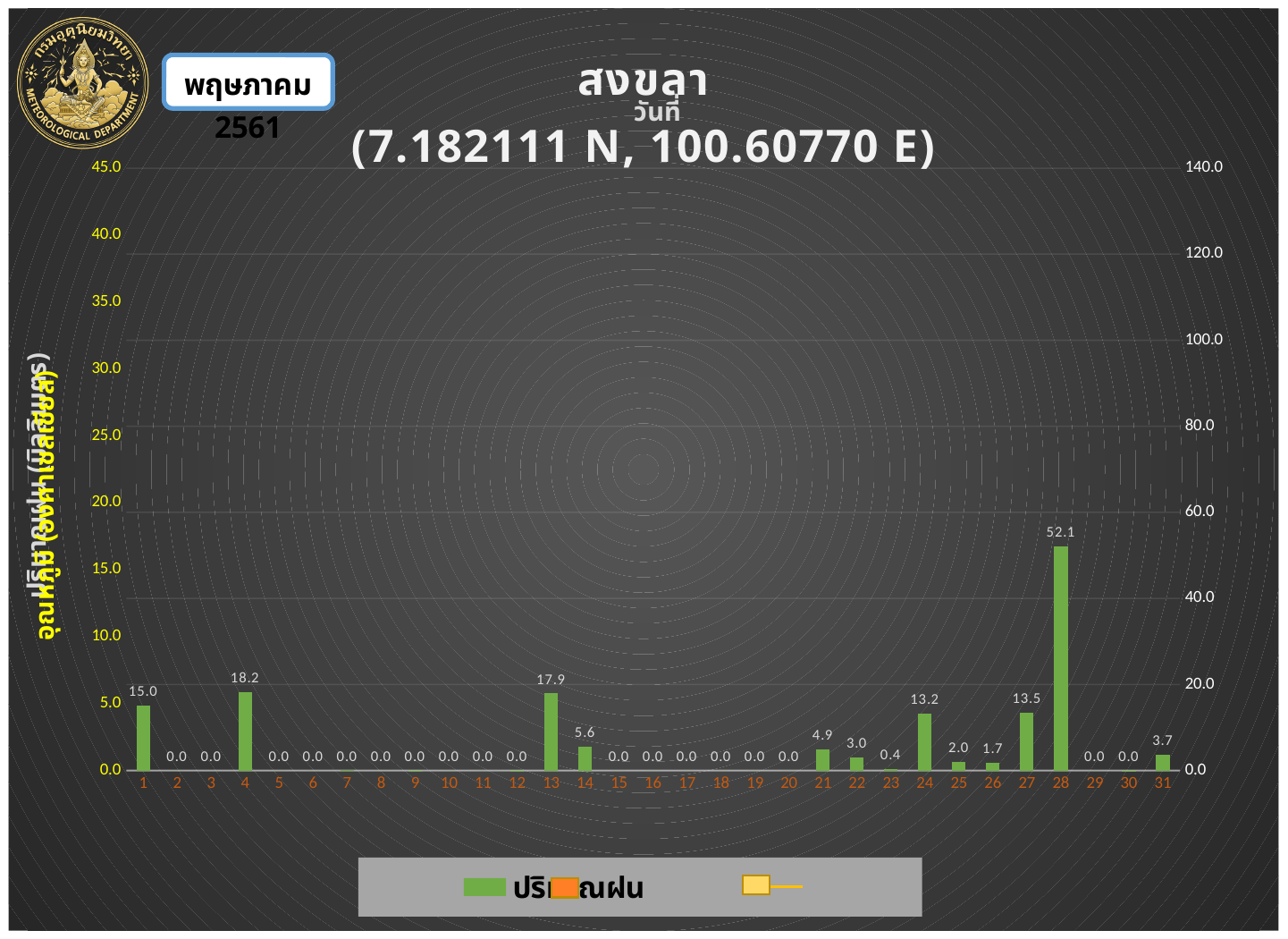
What colour are the bars in the chart? green Which is larger, the value for day 1 or the value for day 4? day 4 What is the total of the values for day 25 and day 26? 3.7 What is the rainfall value shown for day 28? 52.1 Which day has the highest bar? 28 What kind of chart is this? bar chart How many days are shown on the x axis? 31 What is the difference between the values for day 27 and day 24? 0.3 What is the value shown for day 24? 13.2 Which is larger, the value for day 21 or the value for day 22? day 21 What is the value shown for day 4? 18.2 What is the value shown for day 13? 17.9